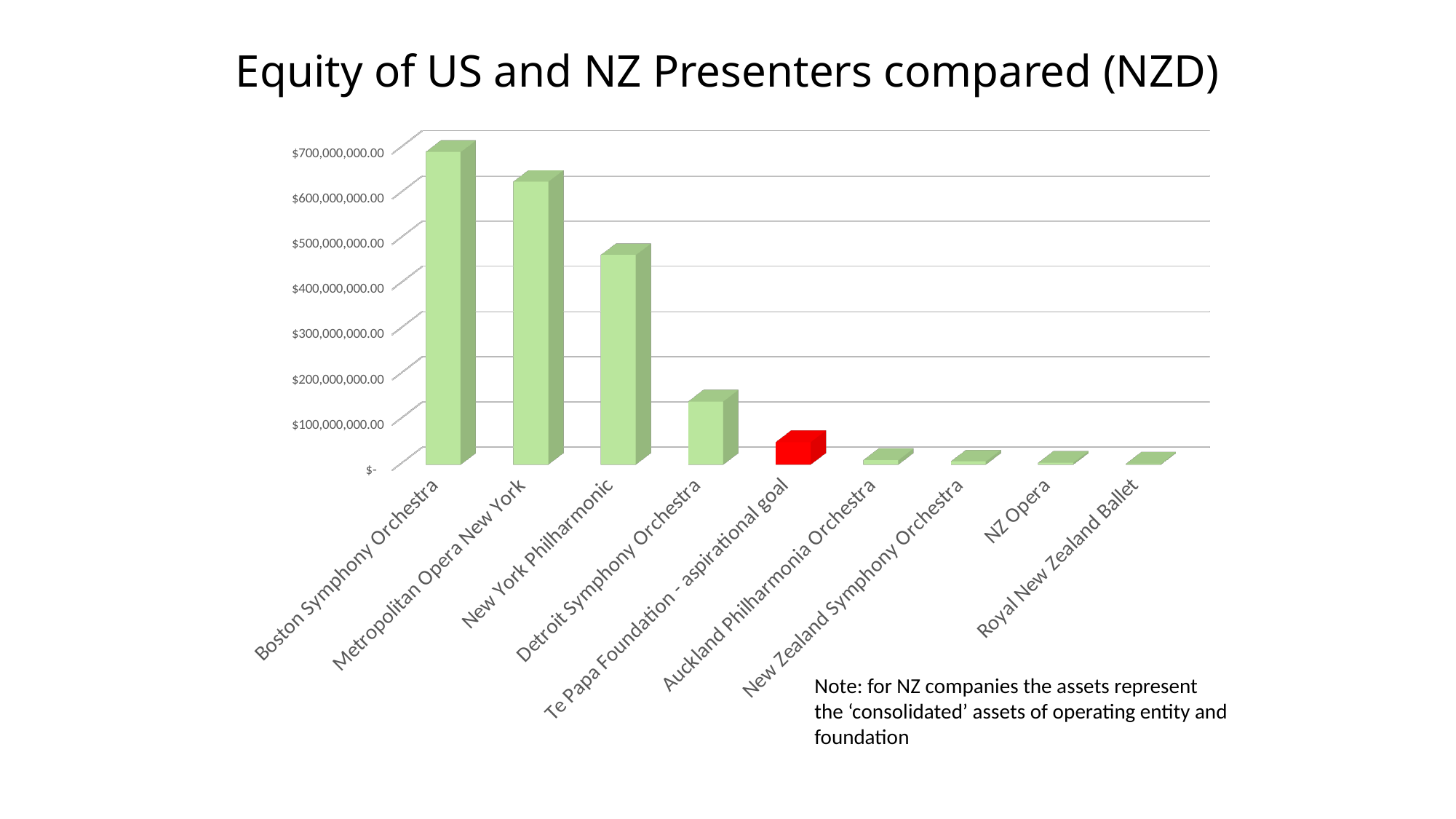
Is the value for New York Philharmonic greater or less than $500,000,000.00? less What kind of chart is shown on the slide? Bar chart Which bar on the chart is coloured red? Te Papa Foundation - aspirational goal Is the value for Detroit Symphony Orchestra greater or less than $100,000,000.00? greater Is the value for Boston Symphony Orchestra greater or less than $600,000,000.00? greater Do the values generally rise or fall moving from left to right along the x axis? Fall How many organisations (categories) are plotted on the chart? 9 Which has the larger equity, Metropolitan Opera New York or New York Philharmonic? Metropolitan Opera New York What is the title of the chart? Equity of US and NZ Presenters compared (NZD) Which has the larger equity, Detroit Symphony Orchestra or NZ Opera? Detroit Symphony Orchestra Which organisation has the highest equity on the chart? Boston Symphony Orchestra